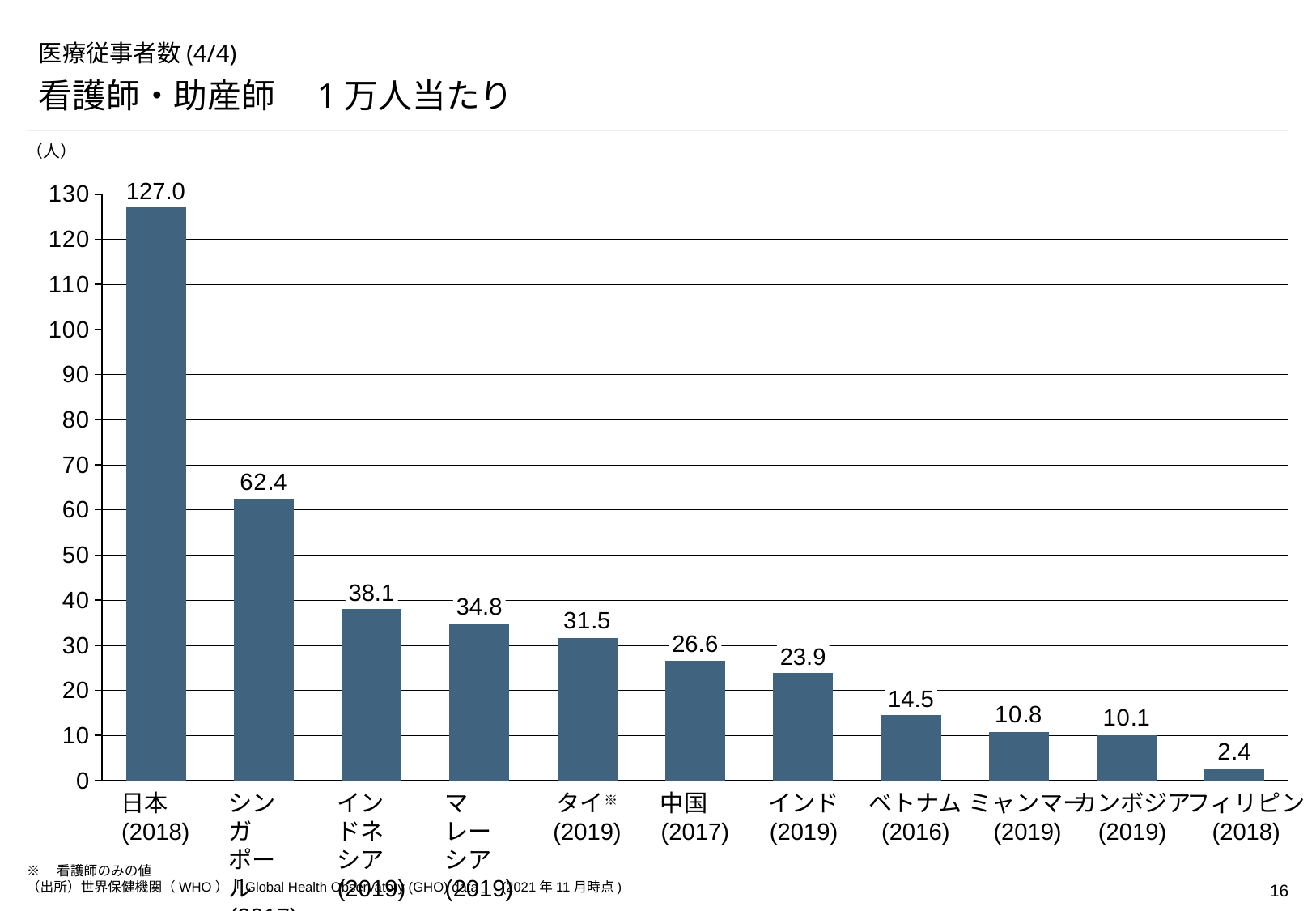
How many countries are shown in the chart? 11 Which has a larger value, インドネシア or マレーシア? インドネシア What is the difference between the values for 中国 and インド? 2.7 Do the values rise or fall from left to right across the chart? fall Is the value for シンガポール greater or less than 60? greater Which country has the highest value in the chart? 日本 What is the value for タイ (2019)? 31.5 What is the value for 日本 (2018) in the chart? 127.0 Which country has the lowest value in the chart? フィリピン What is the value for ベトナム (2016)? 14.5 What kind of chart is shown on the slide? bar chart What is the difference between the values for 日本 and シンガポール? 64.6